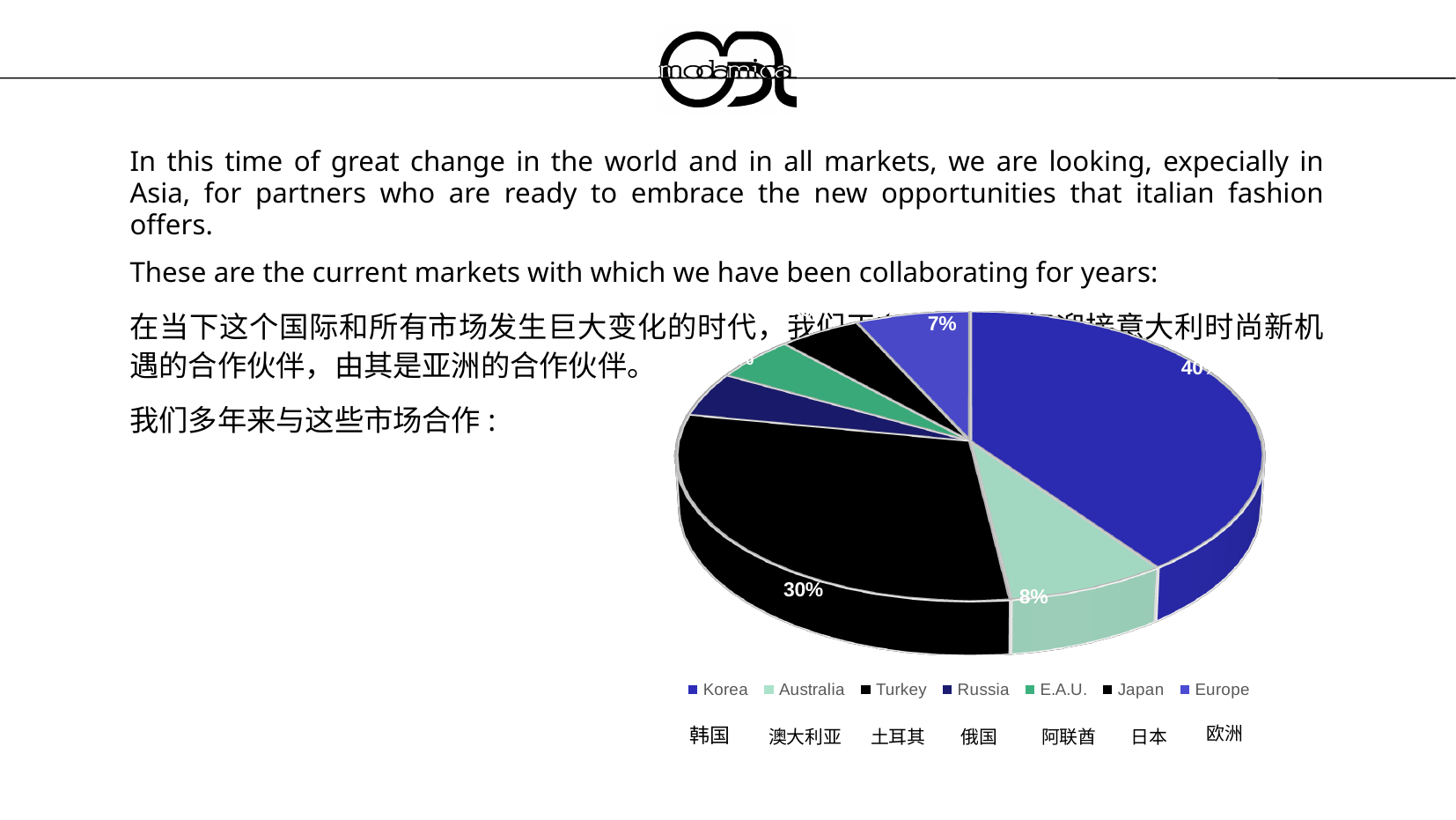
Which legend entry appears last in the pie chart's legend? Europe Which slice is larger, Korea or Turkey? Korea What is the difference in percentage points between the Australia slice and the Europe slice? 1% Which slice is larger, Turkey or Australia? Turkey What percentage of the pie does Europe account for? 7% How many categories does the legend of the pie chart list? 7 What kind of chart is shown on the slide? pie chart Which legend entry appears first in the pie chart's legend? Korea What is the difference in percentage points between the Turkey slice and the Australia slice? 22% What percentage of the pie does Turkey account for? 30% Which market has the largest slice of the pie? Korea What percentage of the pie does Australia account for? 8%